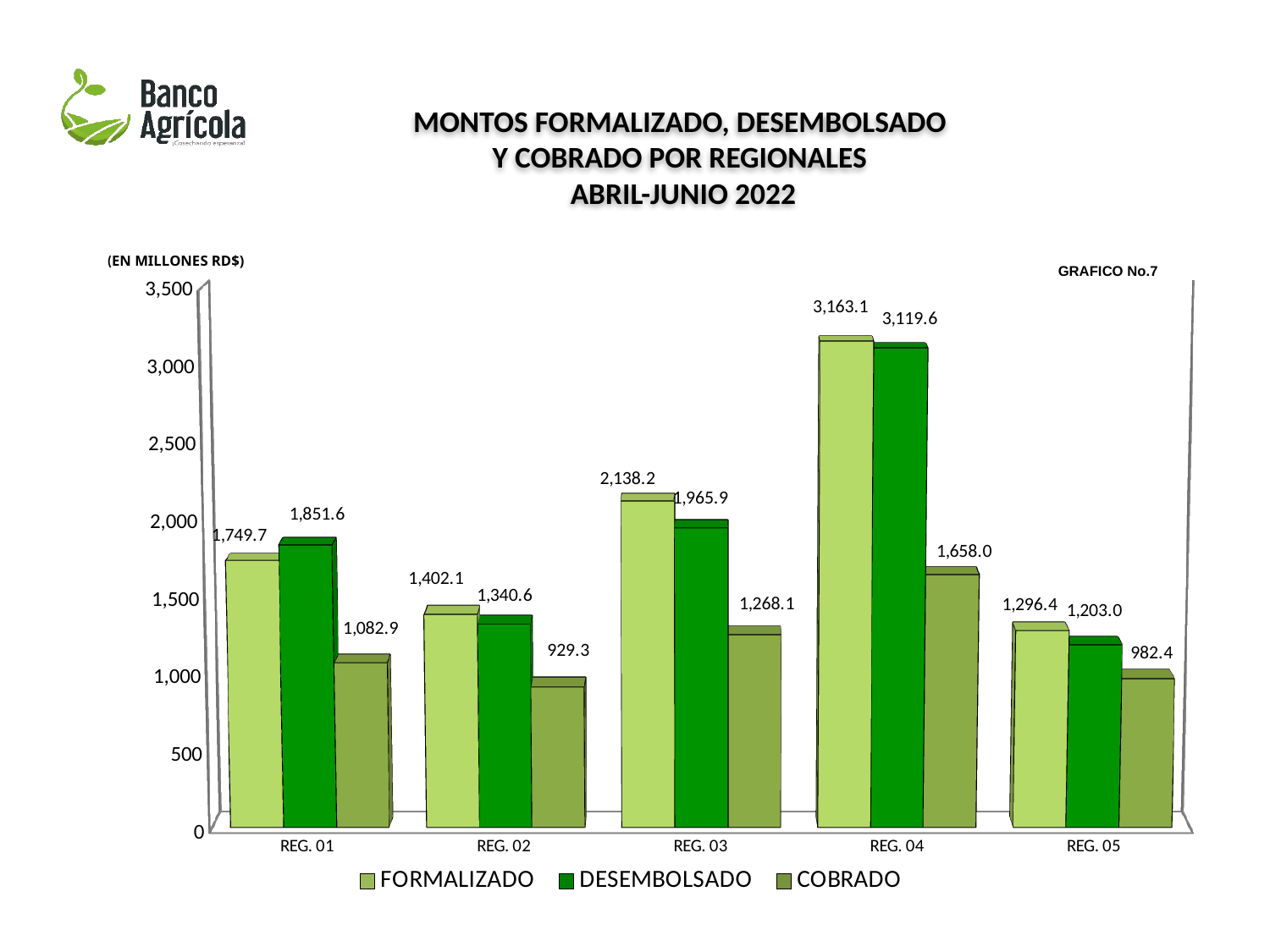
How many series does the legend list? 3 What is the difference between the DESEMBOLSADO and FORMALIZADO values for REG. 01? 101.9 How many regions are shown on the x axis? 5 What is the COBRADO value for REG. 02? 929.3 Which region has the lowest COBRADO value? REG. 02 What is the difference between the FORMALIZADO and COBRADO values for REG. 04? 1,505.1 Which region has the highest FORMALIZADO value? REG. 04 What unit is stated above the chart's vertical axis? EN MILLONES RD$ What kind of chart is shown on the slide? Bar chart What is the DESEMBOLSADO value for REG. 05? 1,203.0 What is the FORMALIZADO value for REG. 04? 3,163.1 Which is larger for REG. 03, FORMALIZADO or DESEMBOLSADO? FORMALIZADO